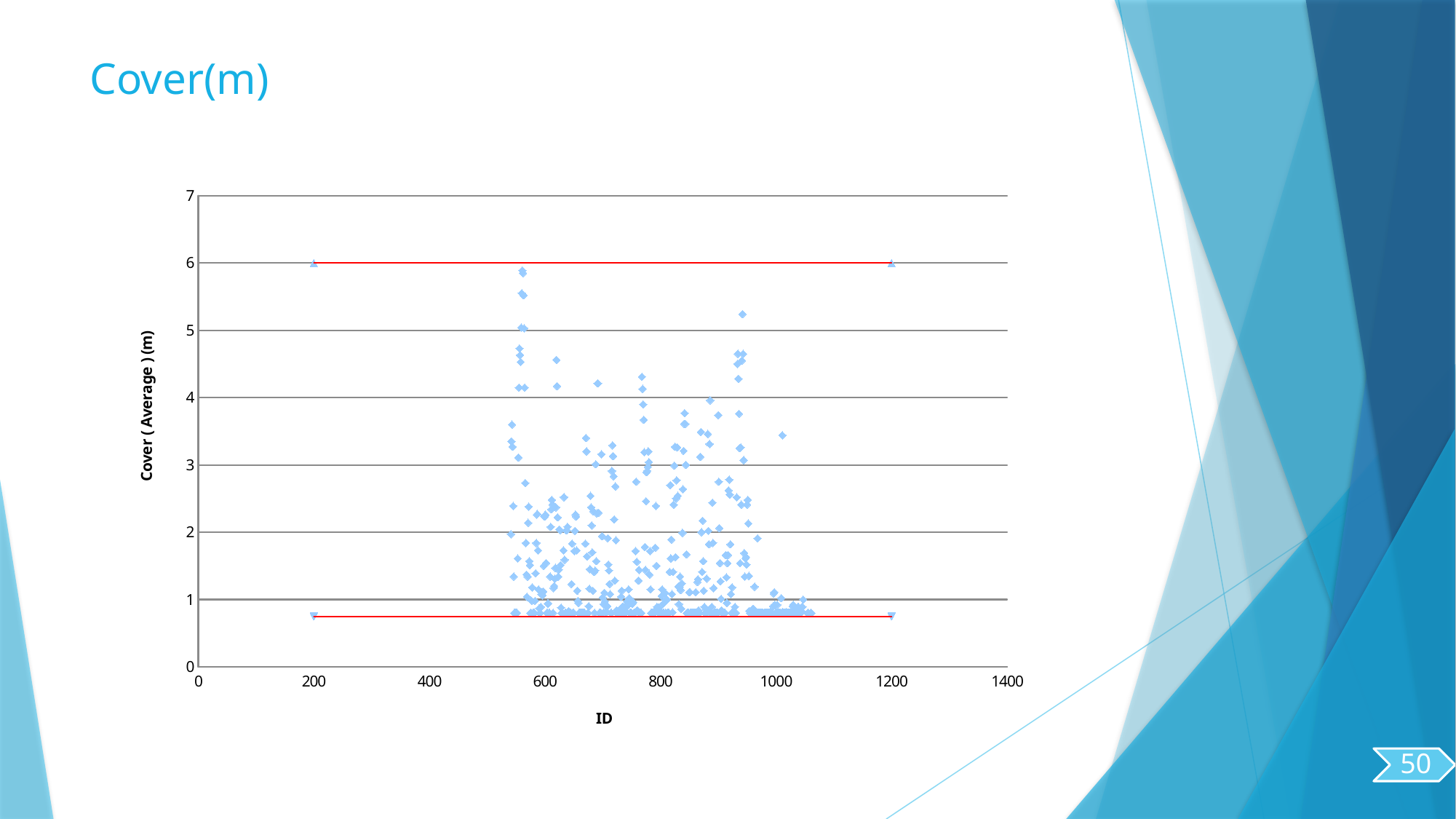
What is the label of the x axis? ID Are the IDs of the scatter points greater or less than 400? greater Is the ID of the scatter point with the highest cover value greater or less than 600? less What kind of chart is shown on the slide? scatter chart Is the highest scatter point's cover value greater or less than 5? greater At what y-axis value does the upper red horizontal line sit? 6 What is the highest value shown on the y axis? 7 At which ID value does the upper red line end on the right? 1200 What is the highest value shown on the x axis? 1400 At which ID value does the upper red line begin on the left? 200 What is the label of the y axis? Cover ( Average ) (m)